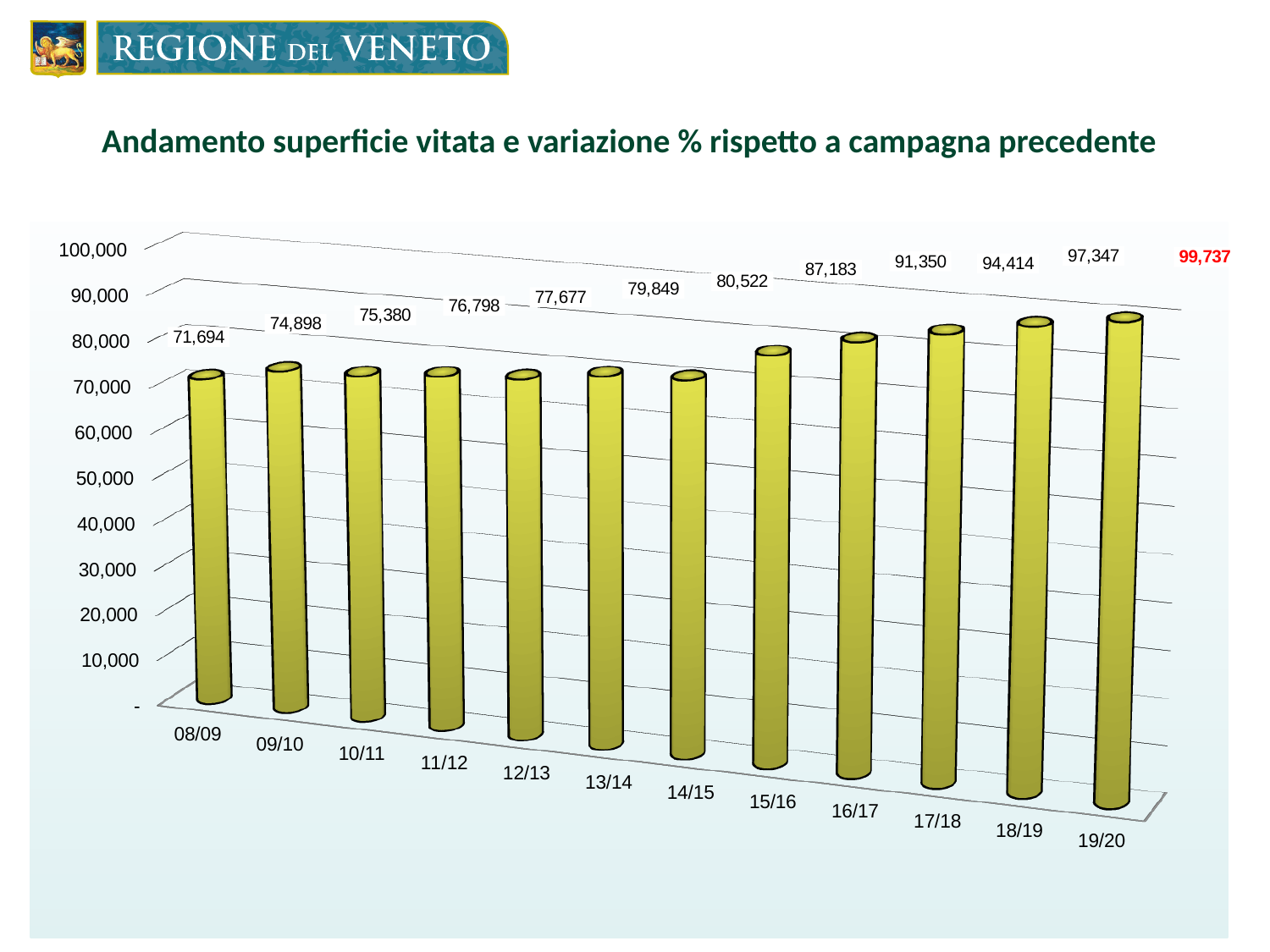
Which is larger, the value for 16/17 or the value for 13/14? 16/17 Do the values rise or fall from 08/09 to 19/20? rise Which campaign has the lowest value? 08/09 What is the difference between the values for 15/16 and 14/15? 6,661 What kind of chart is shown on the slide? bar chart What is the difference between the values for 19/20 and 08/09? 28,043 What is the value for 08/09? 71,694 How many campaigns are shown on the x axis? 12 What is the value for 15/16? 87,183 Which campaign has the highest value? 19/20 Is the value for 17/18 greater or less than 90,000? greater What is the value for 19/20? 99,737